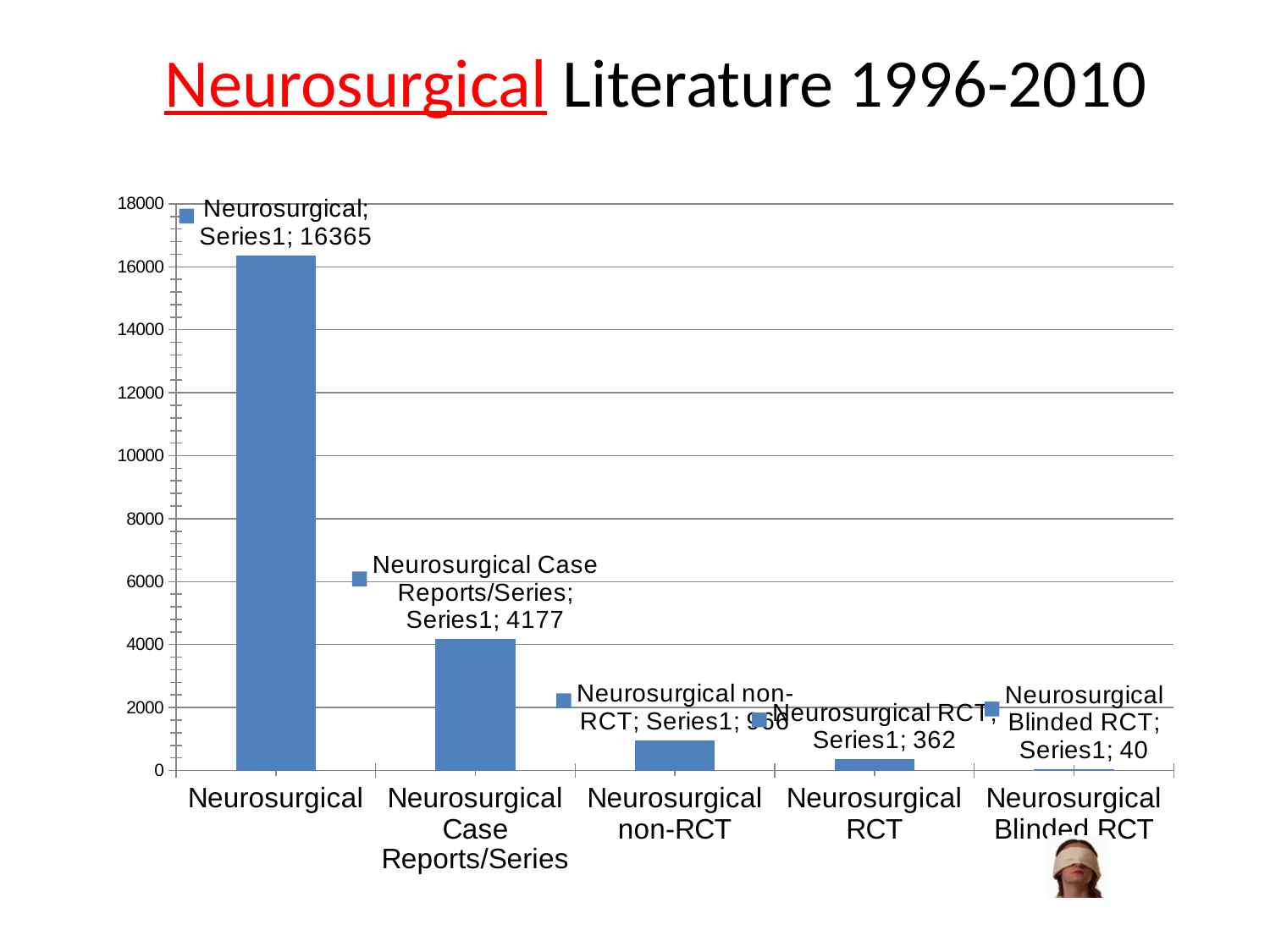
What is the value for Neurosurgical RCT? 362 What is the difference between the values for Neurosurgical RCT and Neurosurgical Blinded RCT? 322 Which is larger, the value for Neurosurgical Case Reports/Series or the value for Neurosurgical RCT? Neurosurgical Case Reports/Series What is the value for Neurosurgical? 16365 Is the value for Neurosurgical non-RCT greater or less than 2000? less What is the value for Neurosurgical Case Reports/Series? 4177 How many categories are shown on the x axis? 5 What kind of chart is shown on the slide? bar chart Which category has the highest value? Neurosurgical What is the value for Neurosurgical Blinded RCT? 40 What is the difference between the values for Neurosurgical and Neurosurgical Case Reports/Series? 12188 Which category has the lowest value? Neurosurgical Blinded RCT